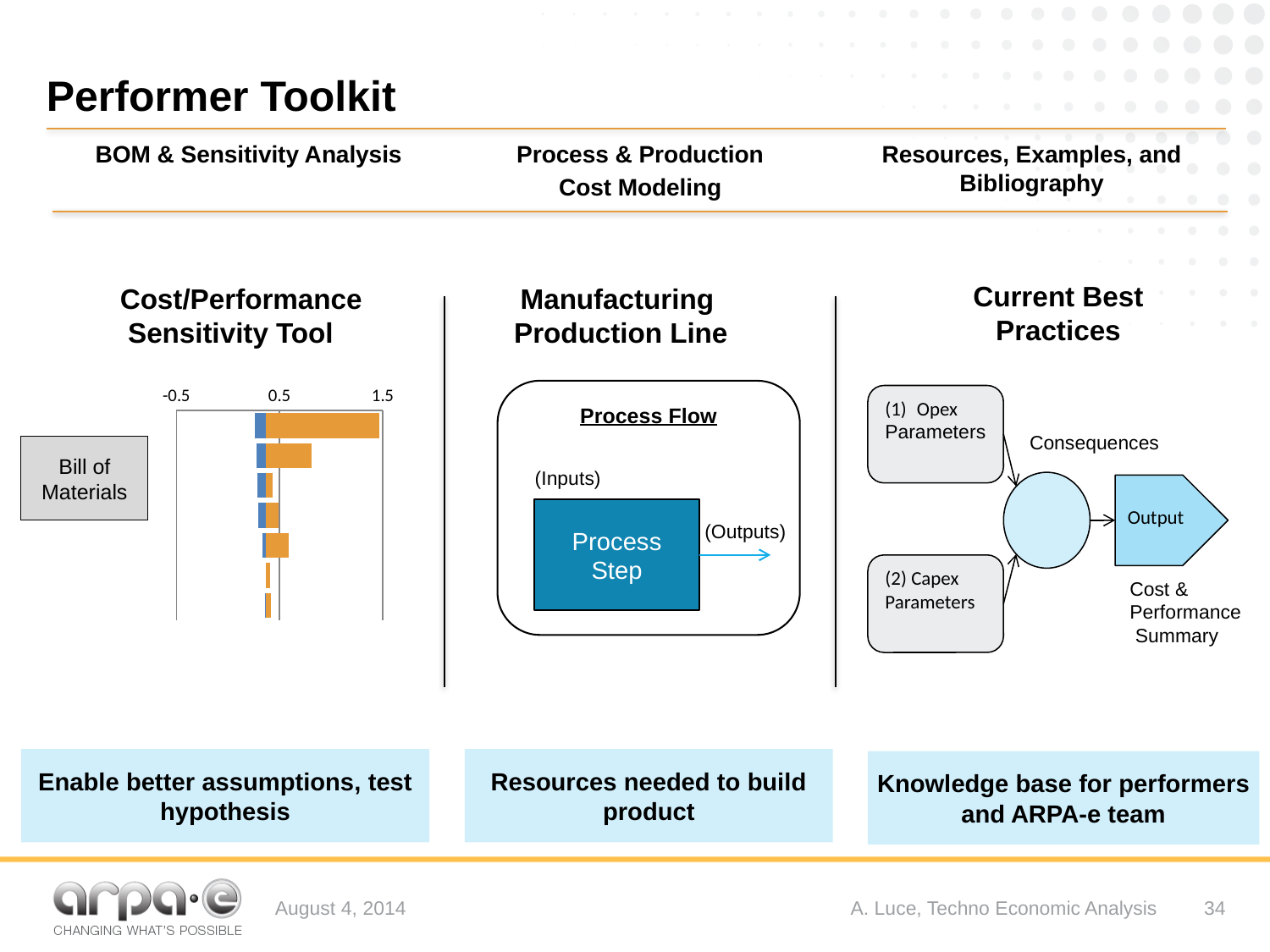
In the Cost/Performance Sensitivity Tool chart, which row has the longest orange bar? the top row In the Cost/Performance Sensitivity Tool chart, is the orange bar in the top row longer or shorter than the orange bar in the second row? longer What two colours are used for the bars in the Cost/Performance Sensitivity Tool chart? blue and orange In the Cost/Performance Sensitivity Tool chart, do the orange bars generally get longer or shorter going from the top row to the bottom row? shorter What kind of chart is shown under the "Cost/Performance Sensitivity Tool" heading? bar chart In the Cost/Performance Sensitivity Tool chart, is the orange bar in the bottom row greater or less than 0.5? less In the Cost/Performance Sensitivity Tool chart, is the orange bar in the top row greater or less than 0.5? greater What are the three tick values shown on the axis of the Cost/Performance Sensitivity Tool chart? -0.5, 0.5, 1.5 In the Cost/Performance Sensitivity Tool chart, how many rows of bars are plotted? 7 In the Cost/Performance Sensitivity Tool chart, is the orange bar in the second row from the top greater or less than 0.5? greater